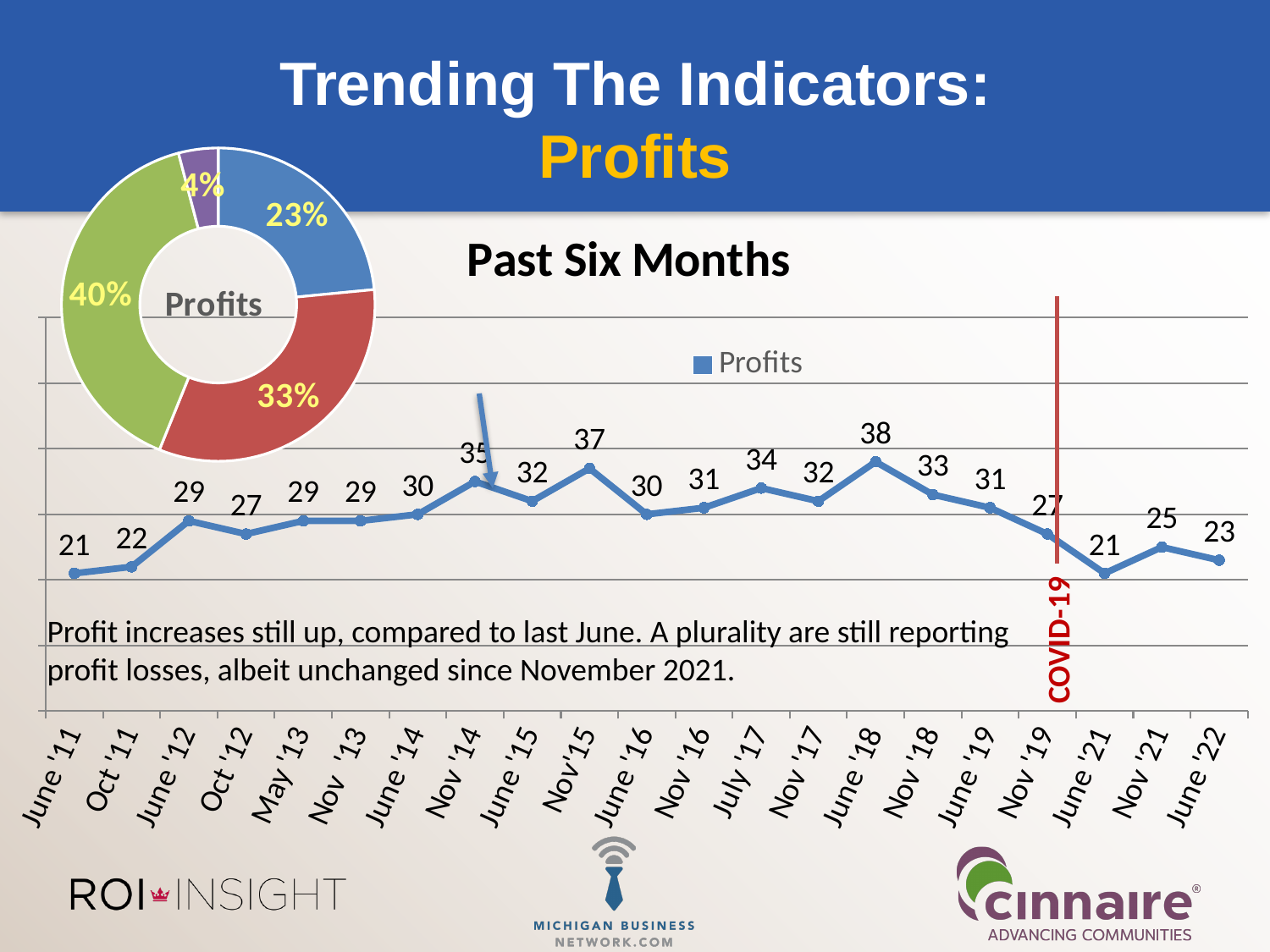
In the 'Past Six Months' line chart, what is the difference between the values for Nov '15 and June '16? 7 How many slices does the 'Profits' donut chart have? 4 In the 'Past Six Months' line chart, do the values rise or fall from June '19 to June '21? Fall How many series does the legend of the 'Past Six Months' chart list? 1 In the 'Past Six Months' line chart, which is larger, the value for Nov '14 or the value for June '15? Nov '14 In the 'Past Six Months' line chart, which period has the highest value? June '18 In the 'Past Six Months' line chart, what is the value for Nov '19? 27 In the 'Profits' donut chart, what is the largest slice's share? 40% In the 'Past Six Months' line chart, what is the value for June '22? 23 In the 'Past Six Months' line chart, what is the value for June '18? 38 How many data points are plotted in the 'Past Six Months' line chart? 21 What kind of chart is the 'Past Six Months' chart? Line chart